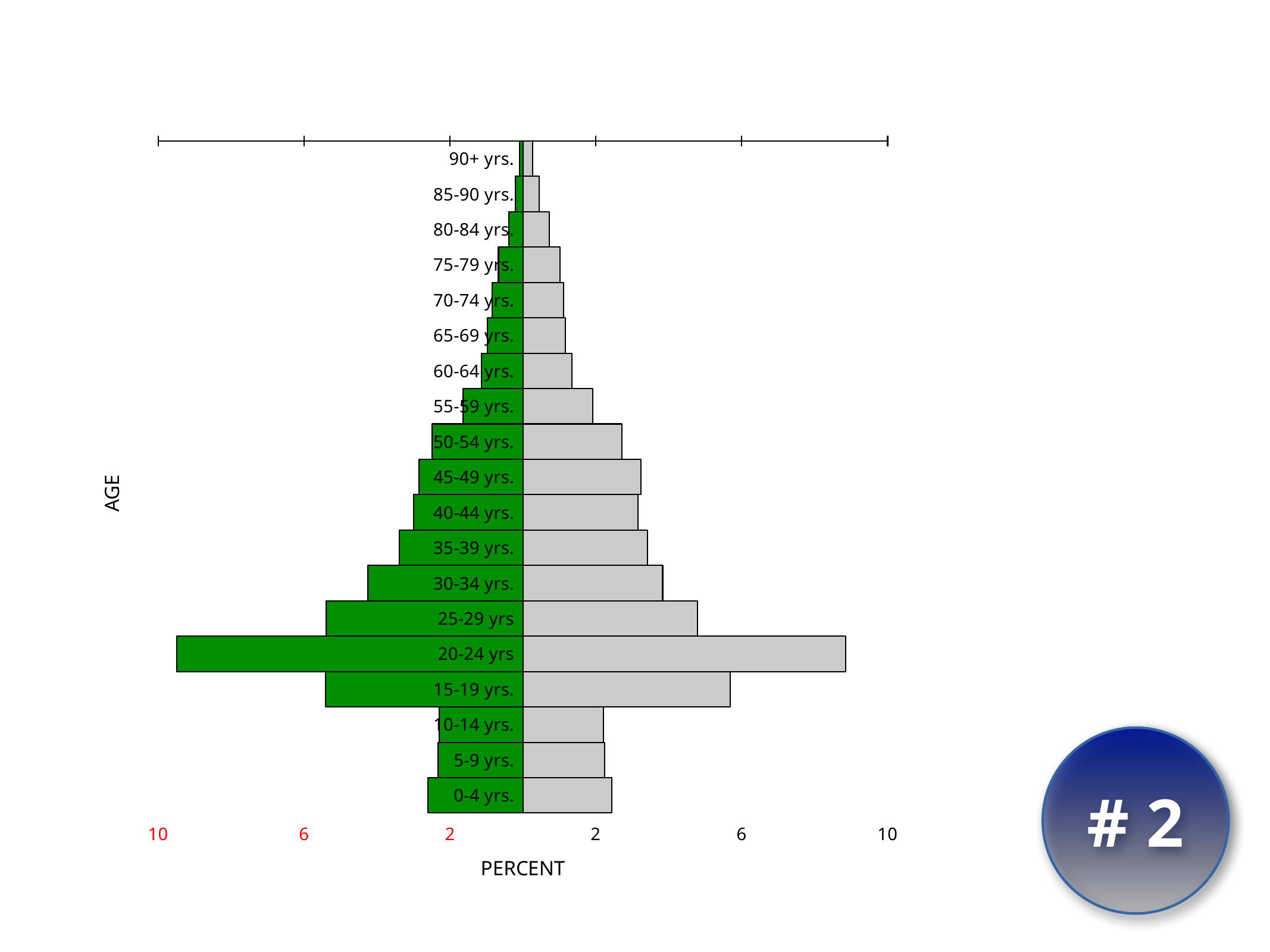
How many age categories are plotted on the chart? 19 Which age category has the longest grey bar on the right side? 20-24 yrs Is the grey (right) value for 15-19 yrs. greater or less than 2? greater Is the grey (right) value for 20-24 yrs greater or less than 6? greater What is the title of the horizontal axis? PERCENT Is the green (left) value for 0-4 yrs. greater or less than 6? less Which age category has the longest green bar on the left side? 20-24 yrs Which age category has the shortest green bar on the left side? 90+ yrs. What kind of chart is shown on the slide? Bar chart (population pyramid) On the green (left) side, which is larger: the bar for 20-24 yrs or the bar for 25-29 yrs? 20-24 yrs